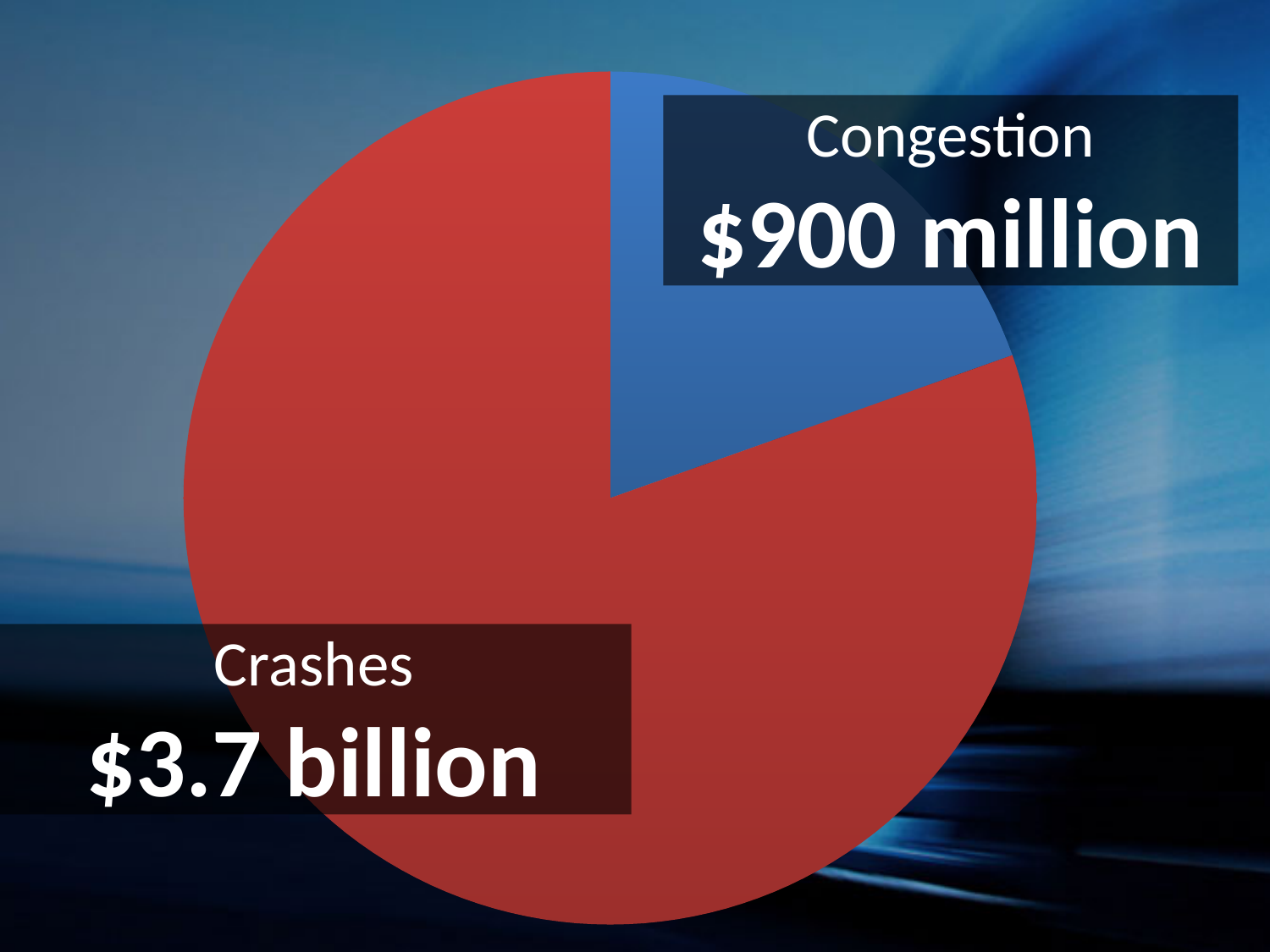
Which is larger, the value for Crashes or the value for Congestion? Crashes Which category has the smallest slice of the pie? Congestion What is the value shown for Crashes? $3.7 billion What colour is the Crashes slice? red What is the total of the two slices in the pie chart? $4.6 billion What colour is the Congestion slice? blue Which category has the largest slice of the pie? Crashes What is the value shown for Congestion? $900 million What is the difference between the Crashes value and the Congestion value? $2.8 billion What kind of chart is shown on the slide? pie chart How many slices does the pie chart have? 2